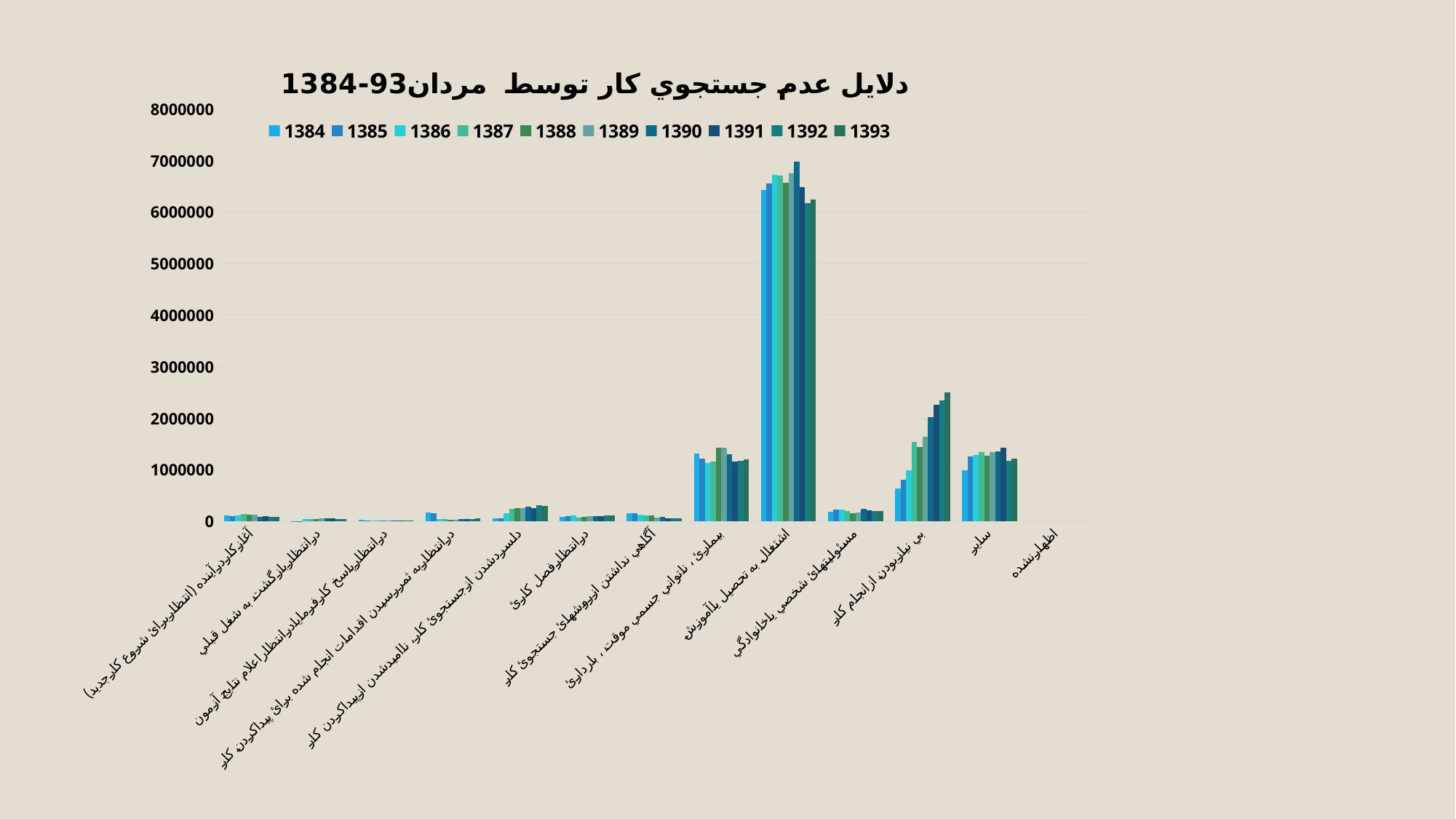
Within the category اشتغال به تحصیل یا آموزش, which year has the tallest bar? 1390 Is the value for 1390 in the category اشتغال به تحصیل یا آموزش greater or less than 6000000? greater What is the title of the chart? دلایل عدم جستجوی کار توسط مردان 1384-93 How many categories are shown along the x axis? 13 How many series does the legend list? 10 Is the value for 1393 in the category مسئولیتهای شخصی یا خانوادگی greater or less than 1000000? less Do the values for بی نیاز بودن از انجام کار rise or fall from 1384 to 1393? rise Is the value for 1388 in the category بیماری، ناتوانی جسمی موقت، بارداری greater or less than 1000000? greater What kind of chart is shown on the slide? bar chart For 1393, which is larger: اشتغال به تحصیل یا آموزش or بی نیاز بودن از انجام کار? اشتغال به تحصیل یا آموزش Which category has the highest values overall? اشتغال به تحصیل یا آموزش